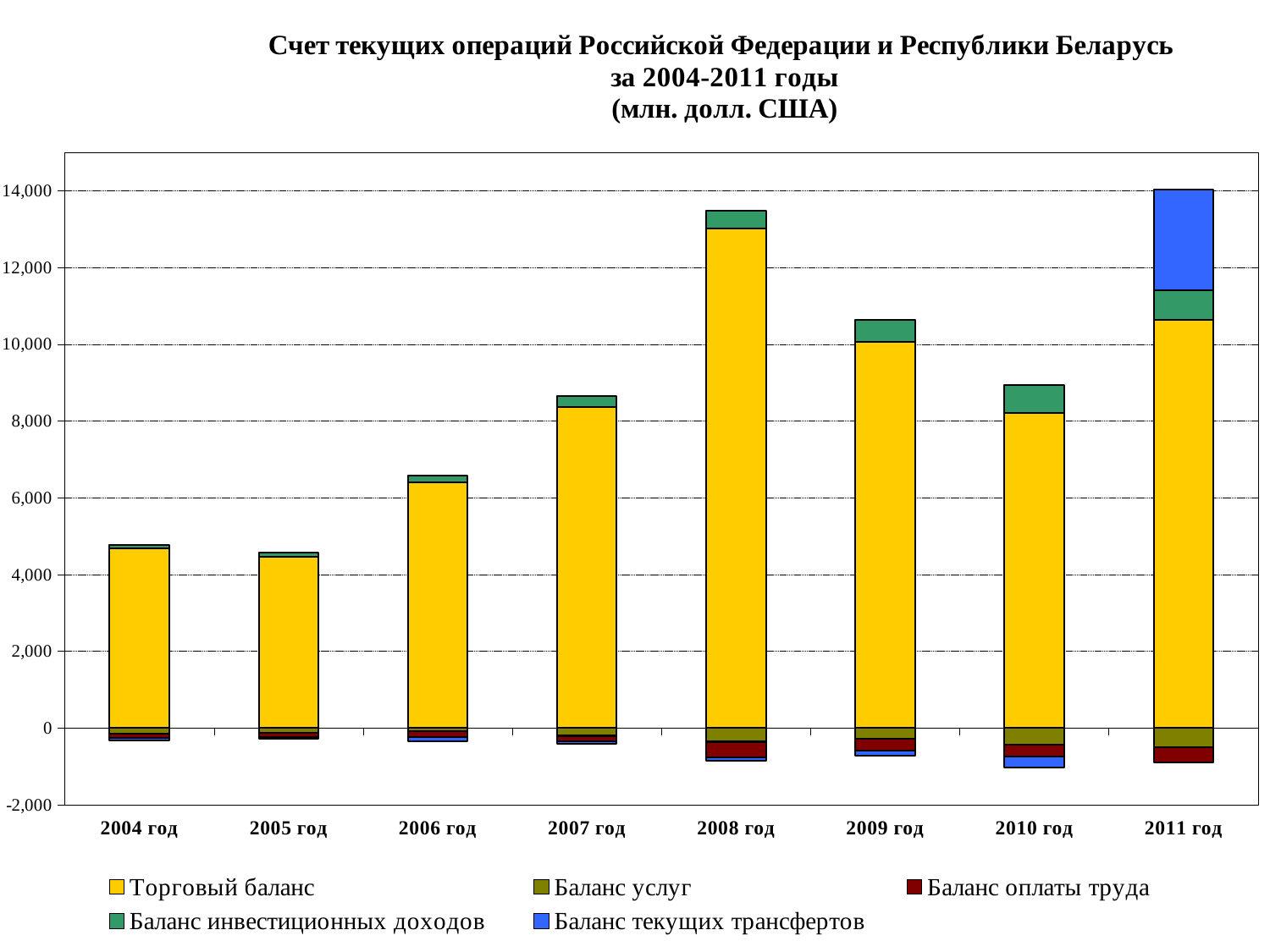
Which year has the larger Торговый баланс, 2008 год or 2009 год? 2008 год How many years (categories) are shown on the x axis? 8 Is the Торговый баланс value for 2006 год greater or less than 6,000? greater Which year has the larger Торговый баланс, 2006 год or 2007 год? 2007 год Is the Торговый баланс value for 2008 год greater or less than 12,000? greater In which year is the Торговый баланс segment the highest? 2008 год What kind of chart is shown on the slide? Stacked bar chart How many series does the legend list? 5 What unit of measurement is given in the chart title? млн. долл. США From 2005 год to 2008 год, does the Торговый баланс rise or fall? rise Is the Торговый баланс value for 2004 год greater or less than 6,000? less In which year is the Баланс текущих трансфертов segment plotted above zero? 2011 год